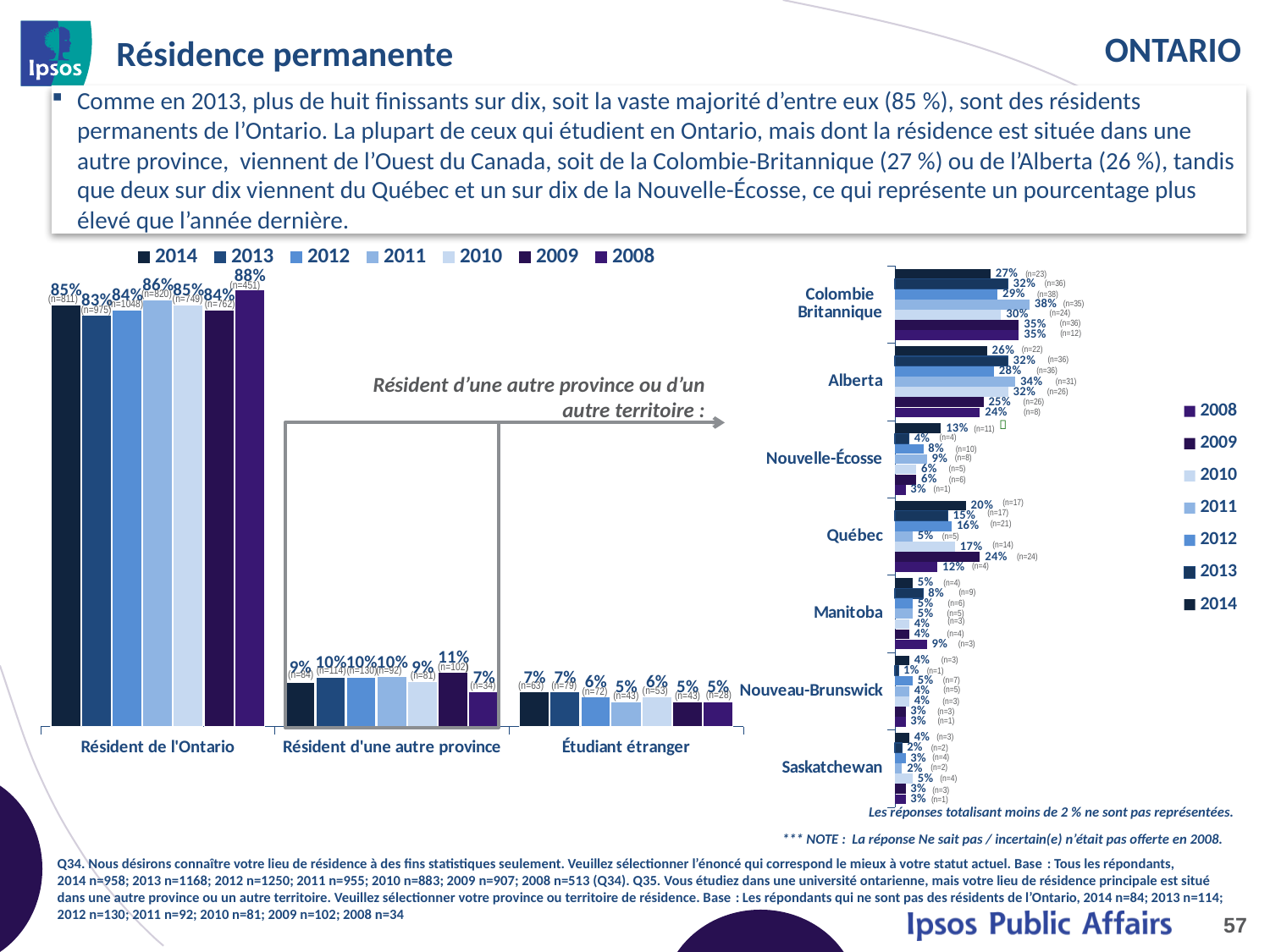
In the right chart, which is larger for 2014: Alberta or Québec? Alberta In the right chart, how many provinces are listed? 7 In the left bar chart, which year has the highest value for Résident de l'Ontario? 2008 In the left bar chart, what is the difference between the 2014 and 2013 values for Résident de l'Ontario? 2% In the right chart, what is the 2014 value for Colombie Britannique? 27% In the left bar chart, what is the 2008 value for Résident d'une autre province? 7% In the left bar chart, how many categories are shown on the x axis? 3 What kind of chart is the chart on the right side of the slide? Bar chart In the left bar chart, what is the 2014 value for Résident de l'Ontario? 85% In the right chart, what is the 2014 value for Nouvelle-Écosse? 13% In the right chart, what is the difference between the 2009 and 2014 values for Québec? 4% In the left bar chart, how many series does the legend list? 7